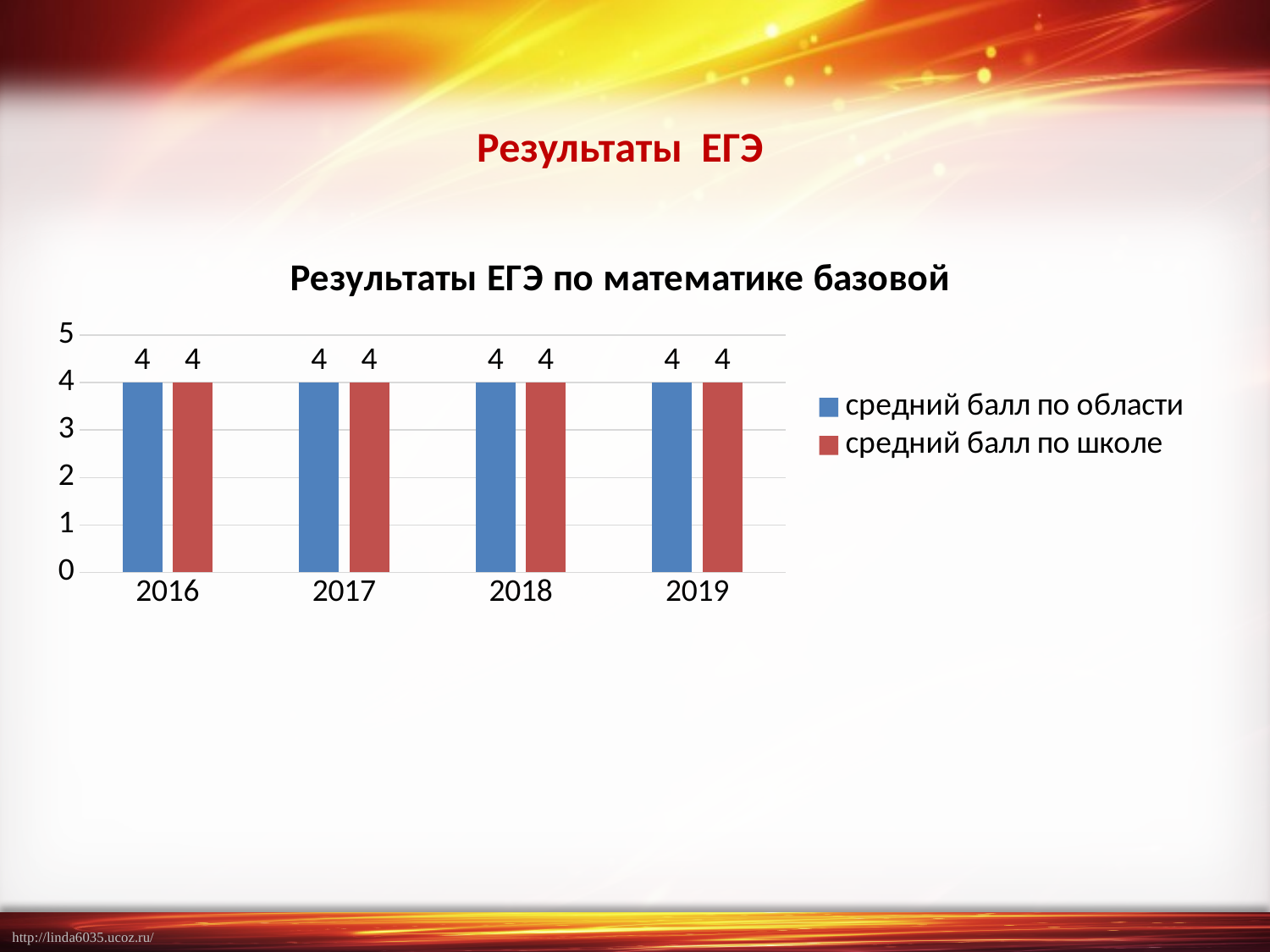
How many years are shown on the x axis? 4 What kind of chart is shown on the slide? bar chart What is the value for 'средний балл по школе' in 2017? 4 What is the value for 'средний балл по школе' in 2019? 4 How many series does the legend list? 2 Which colour represents 'средний балл по школе' in the chart? red What is the value for 'средний балл по области' in 2016? 4 What is the title of the chart? Результаты ЕГЭ по математике базовой Do the values for 'средний балл по школе' rise, fall, or stay the same from 2016 to 2019? stay the same Is the value for 'средний балл по области' in 2017 greater or less than 3? greater What is the difference between 'средний балл по области' and 'средний балл по школе' in 2018? 0